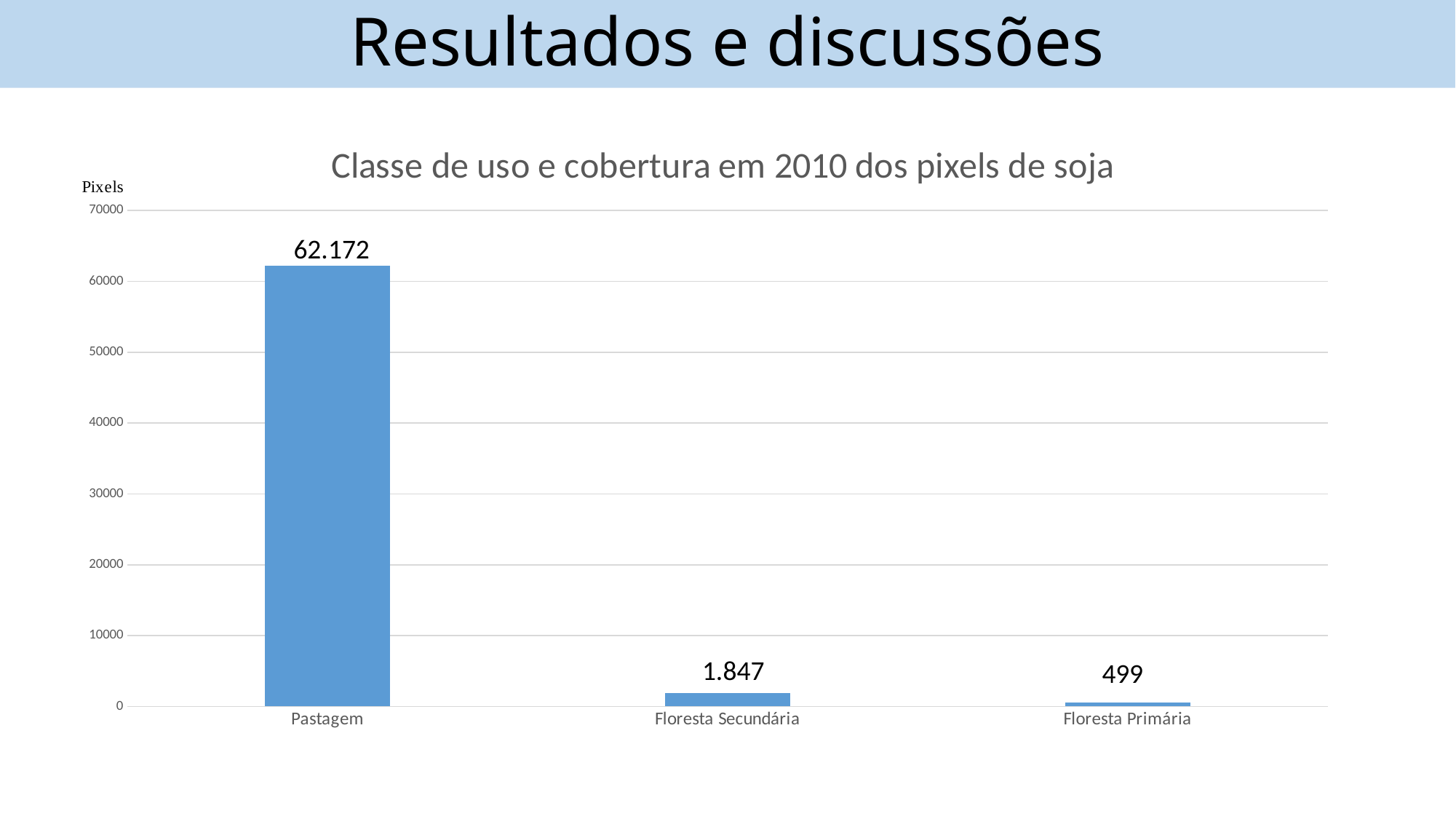
What is the title of the chart? Classe de uso e cobertura em 2010 dos pixels de soja What kind of chart is shown on the slide? Bar chart What is the difference between the values for Floresta Secundária and Floresta Primária? 1.348 What is the difference between the values for Pastagem and Floresta Secundária? 60.325 Which category has the lowest value? Floresta Primária What is the value for Floresta Secundária? 1.847 Which category has the highest value? Pastagem How many categories are shown in the chart? 3 What is the value for Pastagem? 62.172 Which is larger, the value for Floresta Secundária or the value for Floresta Primária? Floresta Secundária What is the value for Floresta Primária? 499 Is the value for Pastagem greater or less than 60000? greater